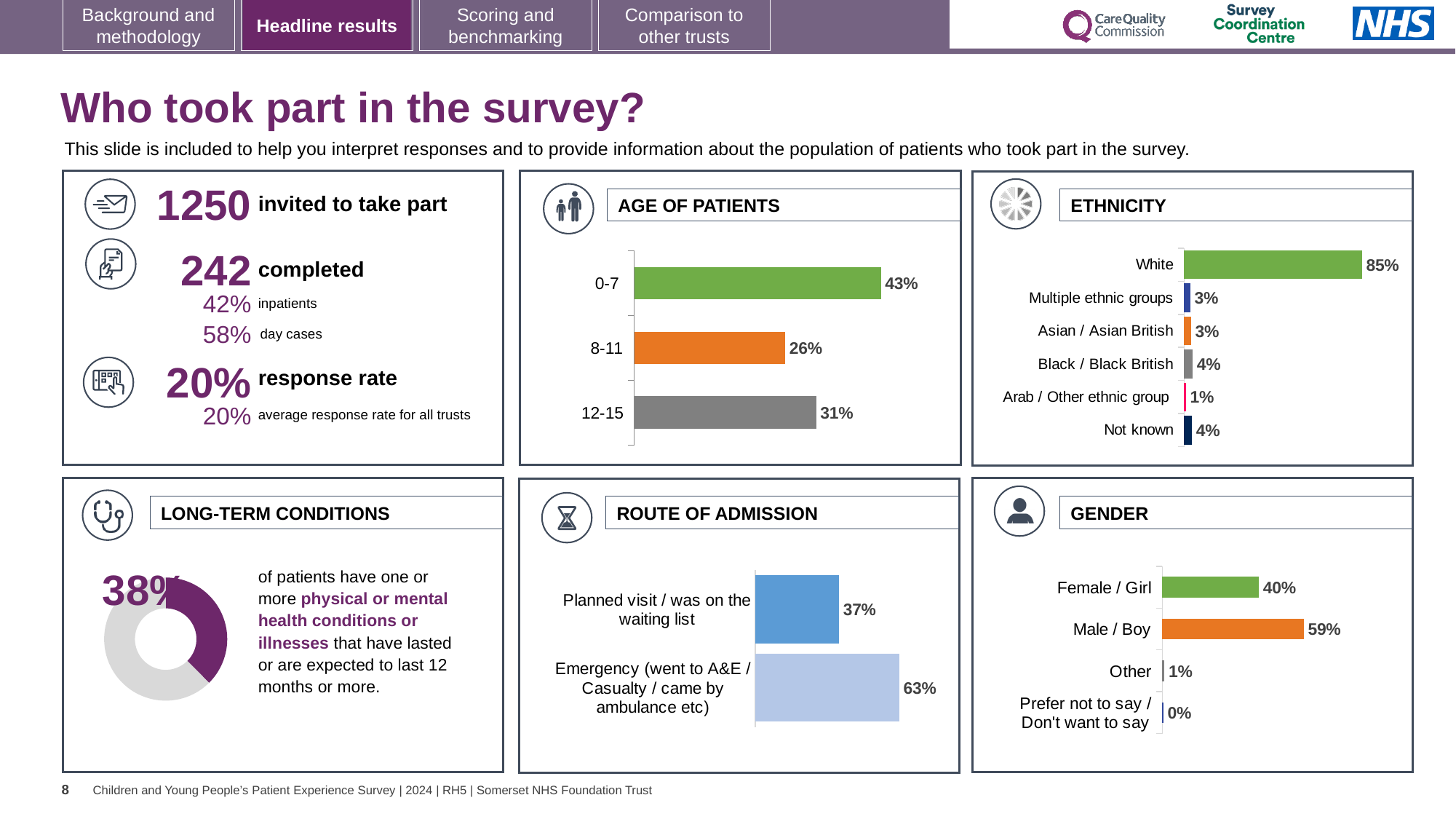
In the GENDER chart, what percentage of patients were Male / Boy? 59% What kind of chart is used in the LONG-TERM CONDITIONS panel? Donut chart In the LONG-TERM CONDITIONS chart, what share of patients have one or more long-term conditions? 38% In the ROUTE OF ADMISSION chart, which route has the larger percentage: Planned visit / was on the waiting list or Emergency? Emergency (went to A&E / Casualty / came by ambulance etc) In the ETHNICITY chart, which category has the lowest percentage? Arab / Other ethnic group How many categories are shown in the ETHNICITY chart? 6 In the ETHNICITY chart, what percentage of patients were White? 85% In the AGE OF PATIENTS chart, what is the difference between the 0-7 and 12-15 percentages? 12% In the AGE OF PATIENTS chart, which age group has the lowest percentage? 8-11 In the AGE OF PATIENTS chart, what percentage of patients were aged 0-7? 43% In the GENDER chart, what is the difference between the Male / Boy and Female / Girl percentages? 19% In the ROUTE OF ADMISSION chart, what percentage of patients came via Emergency (went to A&E / Casualty / came by ambulance etc)? 63%